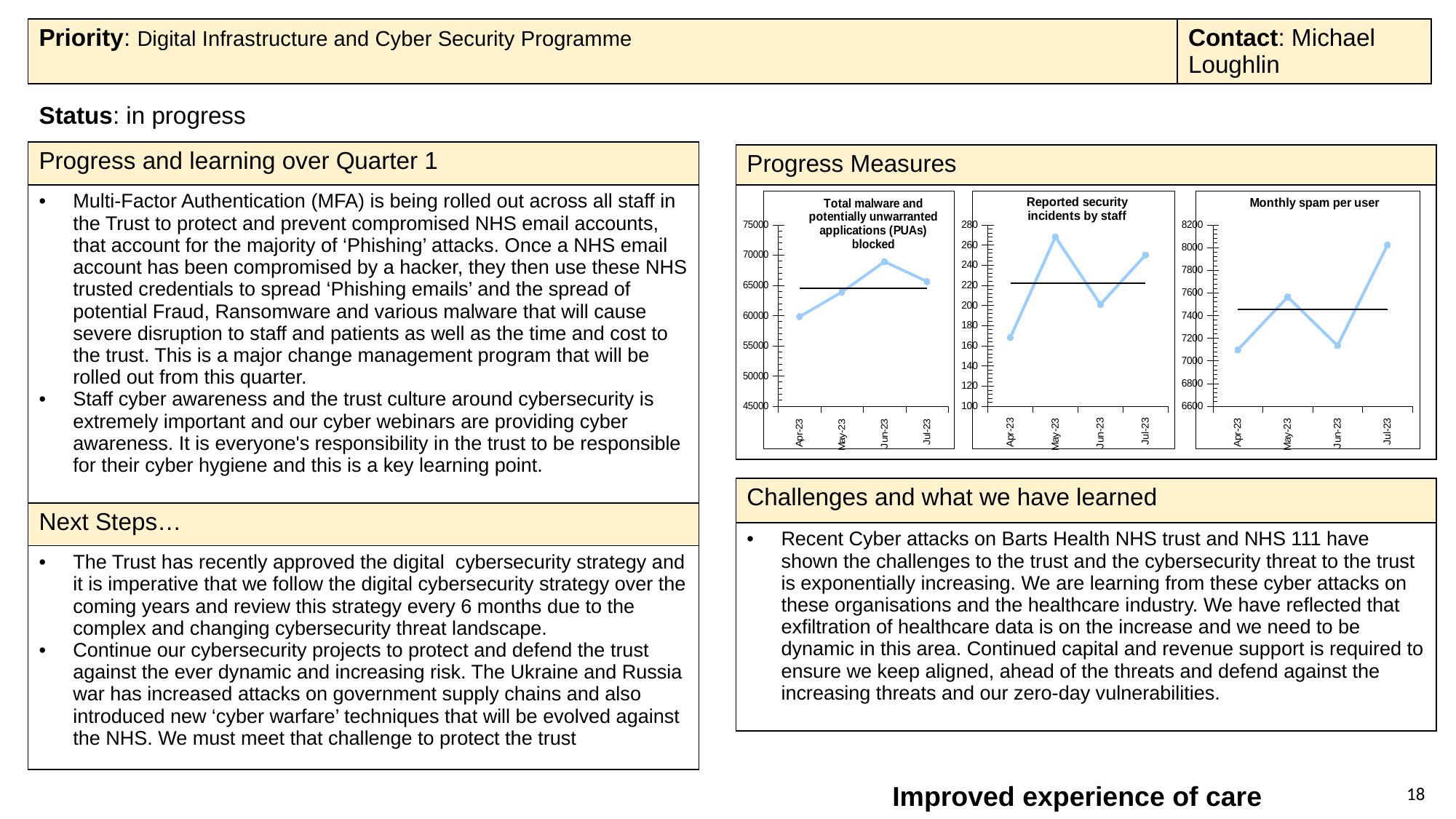
In the 'Total malware and potentially unwarranted applications (PUAs) blocked' chart, is the value for Apr-23 greater or less than 65000? less In the 'Reported security incidents by staff' chart, which month has the lowest value? Apr-23 In the 'Monthly spam per user' chart, which month has the highest value? Jul-23 In the 'Reported security incidents by staff' chart, is the value for Apr-23 greater or less than 200? less In the 'Monthly spam per user' chart, is the value for Jul-23 greater or less than 7800? greater In the 'Reported security incidents by staff' chart, which month has the highest value? May-23 How many months are plotted on the 'Reported security incidents by staff' chart? 4 In the 'Reported security incidents by staff' chart, which is larger, the value for May-23 or Jun-23? May-23 How many charts are shown in the 'Progress Measures' section? 3 In the 'Total malware and potentially unwarranted applications (PUAs) blocked' chart, which month has the highest value? Jun-23 In the 'Total malware and potentially unwarranted applications (PUAs) blocked' chart, which month has the lowest value? Apr-23 What kind of chart is the 'Monthly spam per user' chart? line chart